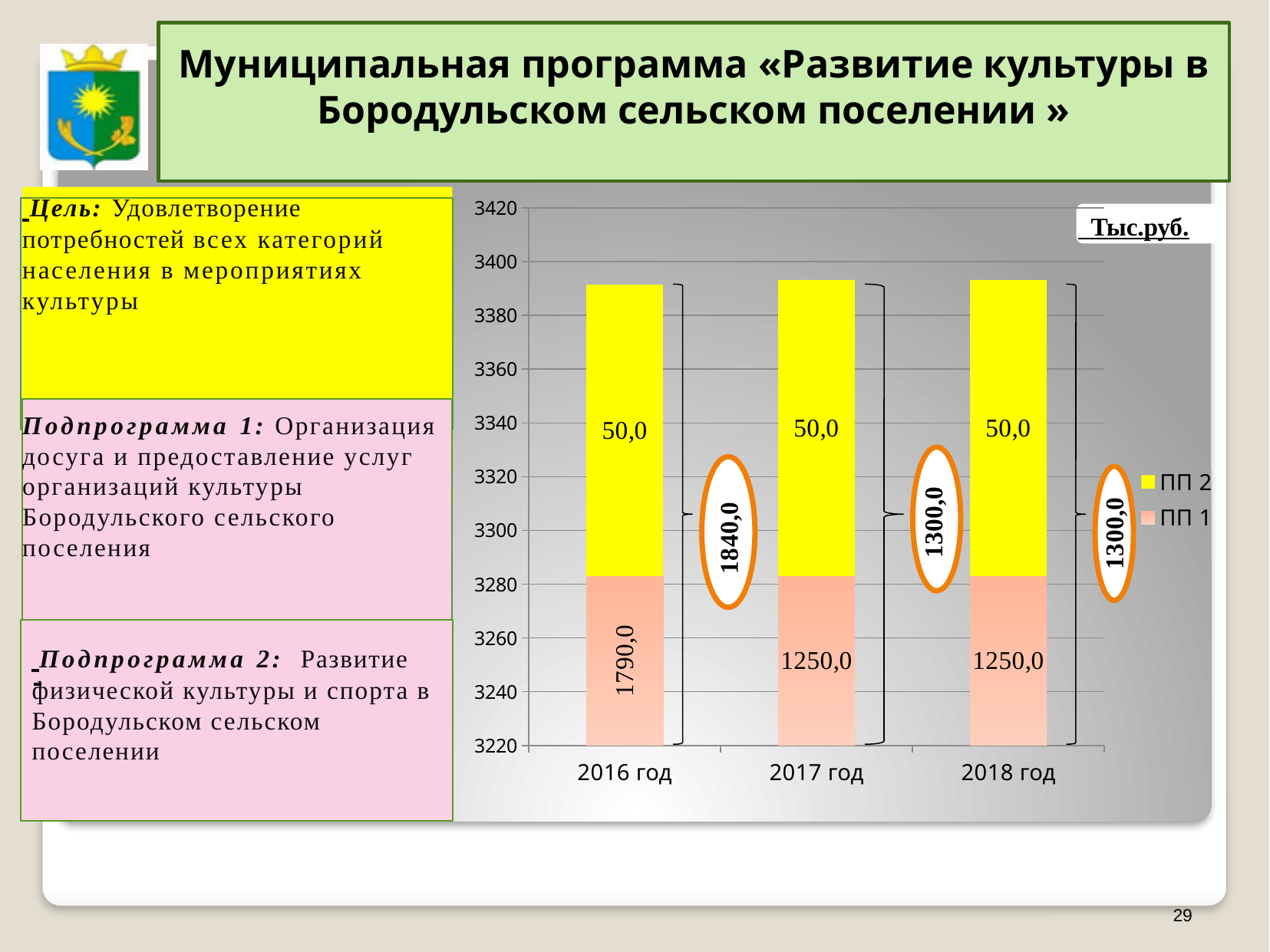
What is the value of ПП 2 for 2018 год? 50,0 What kind of chart is shown on the slide? bar chart What is the value of ПП 1 for 2016 год? 1790,0 Which year has the highest value for ПП 1? 2016 год What is the value of ПП 1 for 2017 год? 1250,0 What unit is indicated in the box at the top right of the chart? Тыс.руб. Which is larger, the ПП 1 value for 2016 год or for 2018 год? 2016 год How many series does the chart legend list? 2 How many year categories are shown on the x axis of the chart? 3 What is the total shown for the 2016 год bar? 1840,0 What is the difference between the ПП 1 values for 2016 год and 2017 год? 540,0 What is the total shown for the 2017 год bar? 1300,0